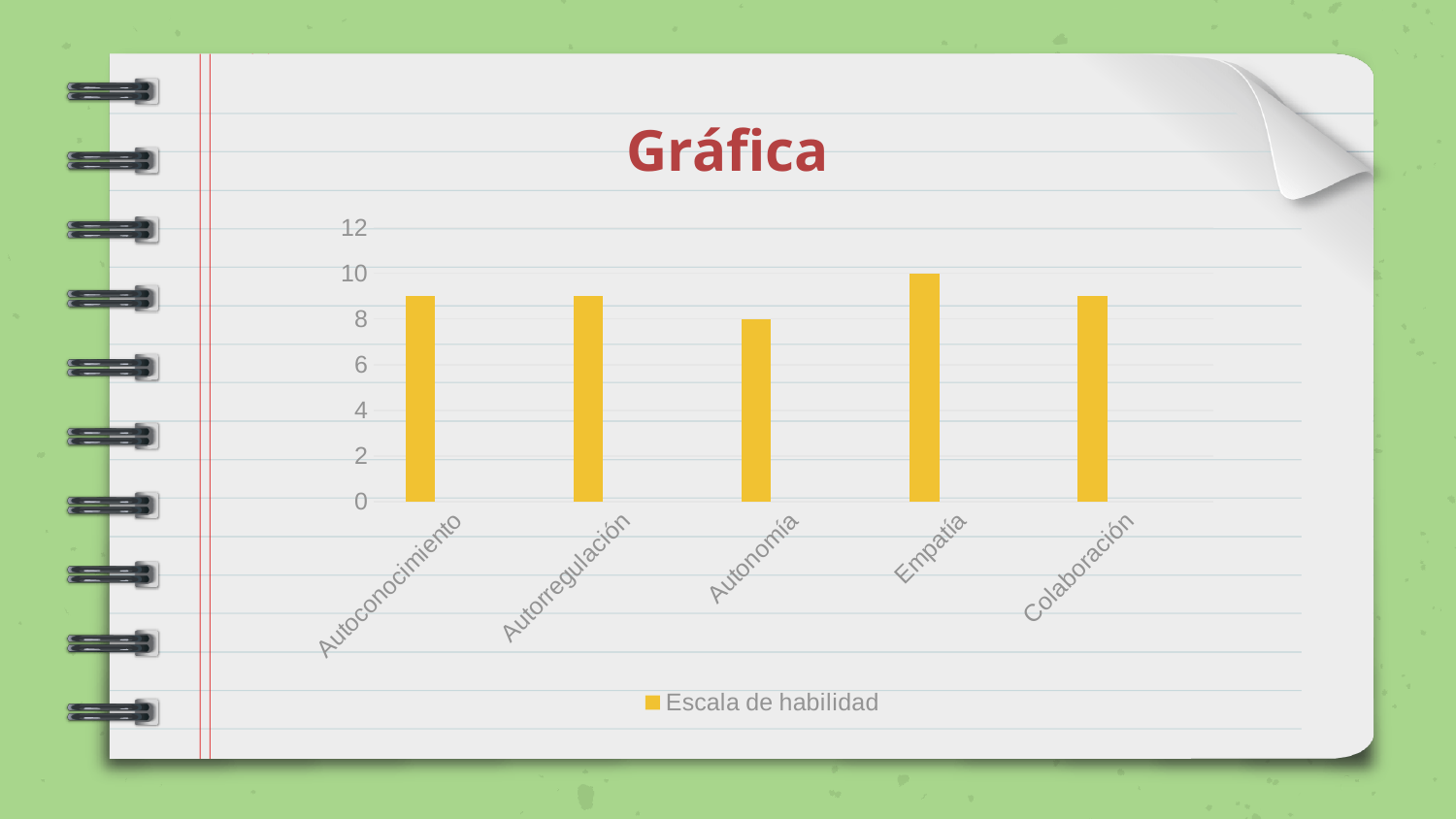
Is the value for Autoconocimiento greater or less than 8? greater Which category has the highest value in the chart? Empatía What is the value for Empatía? 10 What is the title of the chart? Gráfica What series name is shown in the chart's legend? Escala de habilidad Which category has the lowest value in the chart? Autonomía What is the value for Autonomía? 8 How many categories are shown on the x axis of the chart? 5 Which is larger, the value for Empatía or the value for Autonomía? Empatía Is the value for Colaboración greater or less than 10? less What kind of chart is shown on the slide? bar chart How many series does the chart's legend list? 1